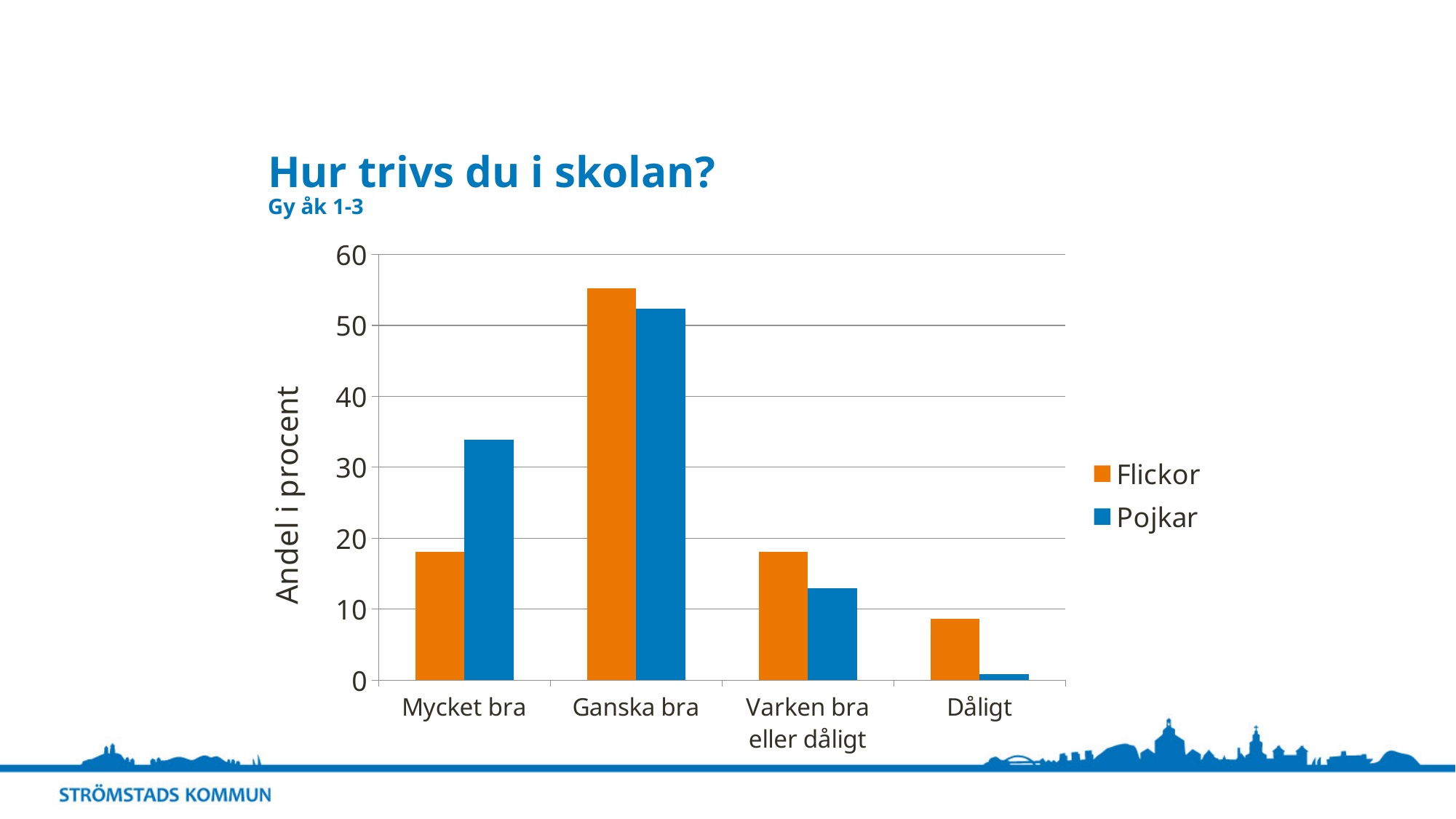
Is the Flickor value for Dåligt greater or less than 10? less For Mycket bra, which series has the larger value, Flickor or Pojkar? Pojkar Is the Pojkar value for Mycket bra greater or less than 30? greater What is the title of the y axis? Andel i procent What kind of chart is shown on the slide? bar chart Which series is shown in orange? Flickor How many series does the legend list? 2 Is the Flickor value for Ganska bra greater or less than 50? greater For Dåligt, which series has the larger value, Flickor or Pojkar? Flickor For Flickor, which category has the highest value? Ganska bra For Pojkar, which category has the lowest value? Dåligt How many response categories are shown on the x axis? 4